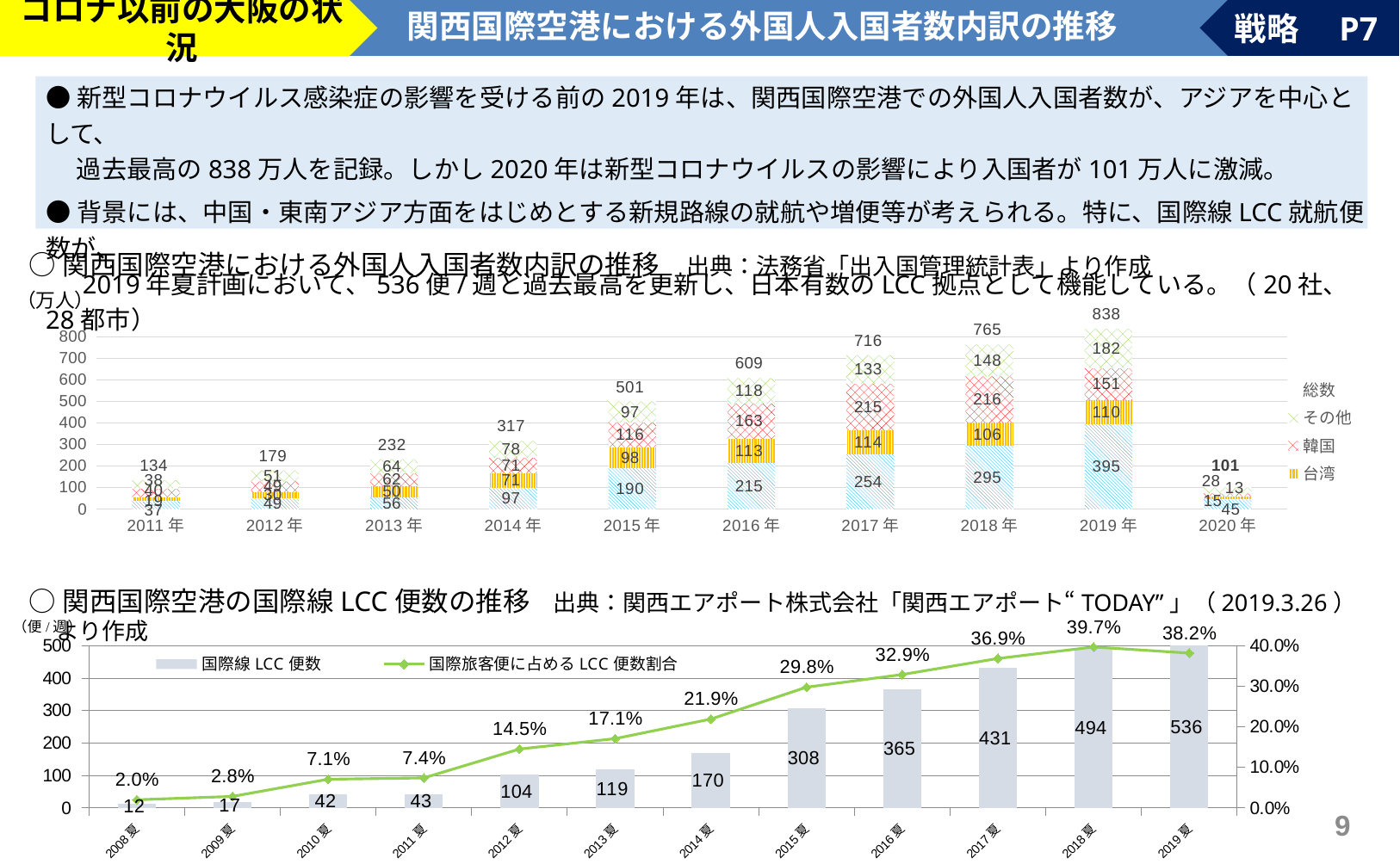
In the bottom chart (関西国際空港の国際線LCC便数の推移), which year has the highest LCC share (国際旅客便に占めるLCC便数割合)? 2018夏 In the top chart (関西国際空港における外国人入国者数内訳の推移), is the 台湾 value for 2019年 larger or smaller than the 韓国 value for 2019年? smaller In the bottom chart (関西国際空港の国際線LCC便数の推移), what is the number of 国際線LCC便数 for 2019夏? 536 In the top chart (関西国際空港における外国人入国者数内訳の推移), what is the difference between the totals for 2019年 and 2018年? 73 In the bottom chart (関西国際空港の国際線LCC便数の推移), how many series does the legend list? 2 In the top chart (関西国際空港における外国人入国者数内訳の推移), what is the 韓国 value for 2018年? 216 In the top chart (関西国際空港における外国人入国者数内訳の推移), which year has the highest total? 2019年 In the bottom chart (関西国際空港の国際線LCC便数の推移), what is the 国際旅客便に占めるLCC便数割合 for 2018夏? 39.7% In the top chart (関西国際空港における外国人入国者数内訳の推移), how many years are shown on the x axis? 10 In the top chart (関西国際空港における外国人入国者数内訳の推移), which year has the lowest total? 2020年 In the top chart (関西国際空港における外国人入国者数内訳の推移), what is the total (総数) for 2019年? 838 In the bottom chart (関西国際空港の国際線LCC便数の推移), what is the difference in 国際線LCC便数 between 2019夏 and 2018夏? 42